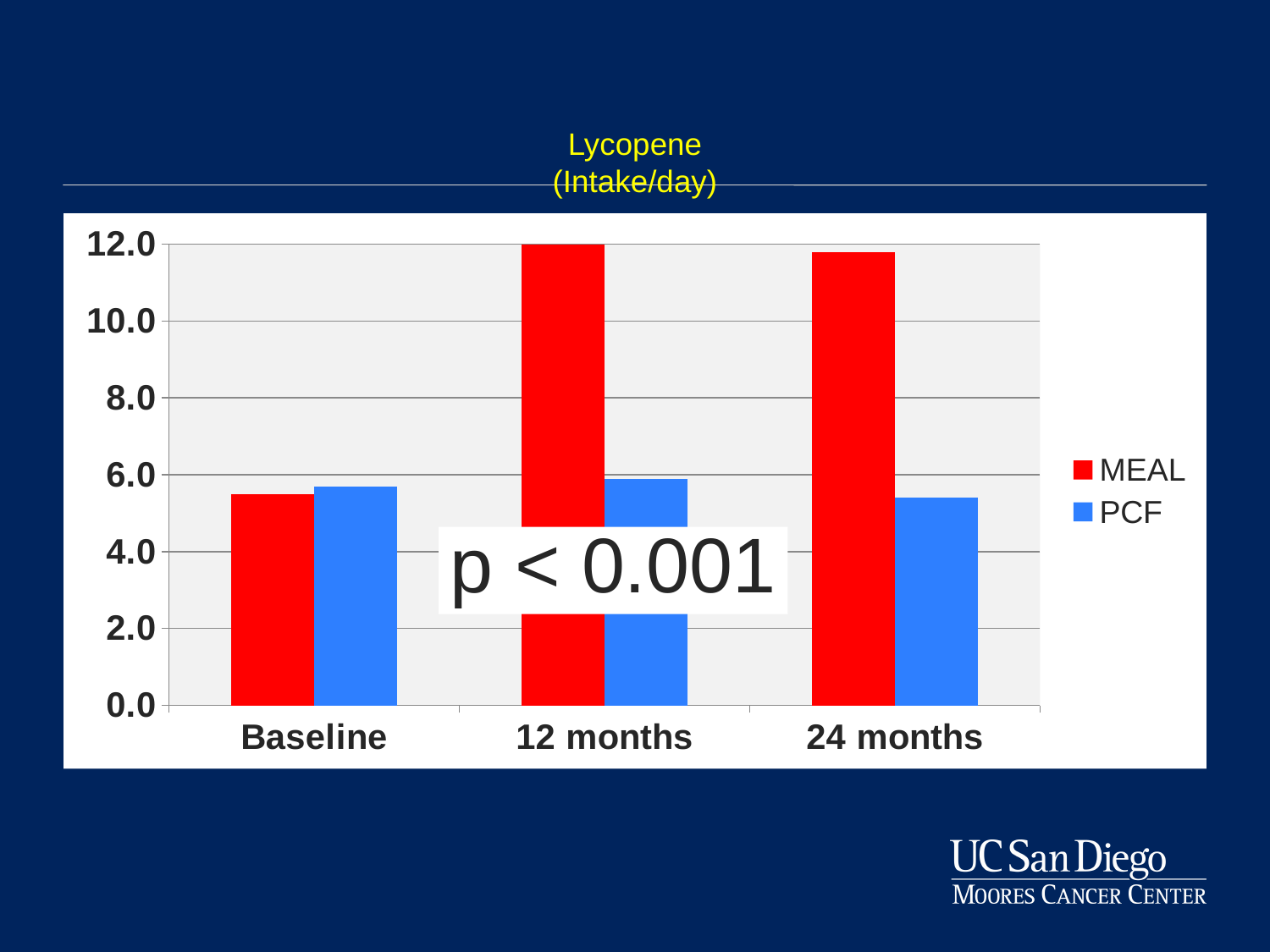
How many series does the legend list? 2 What is the title of the chart? Lycopene (Intake/day) Does the MEAL value rise or fall from Baseline to 12 months? rise Is the PCF value at 24 months greater or less than 6.0? less Is the PCF value at 12 months greater or less than 4.0? greater What kind of chart is shown on the slide? bar chart Which colour represents the MEAL series? red Which category has the lowest MEAL value? Baseline Is the MEAL value at 12 months greater or less than 10.0? greater How many categories are shown on the x axis? 3 At 24 months, which series has the larger value, MEAL or PCF? MEAL